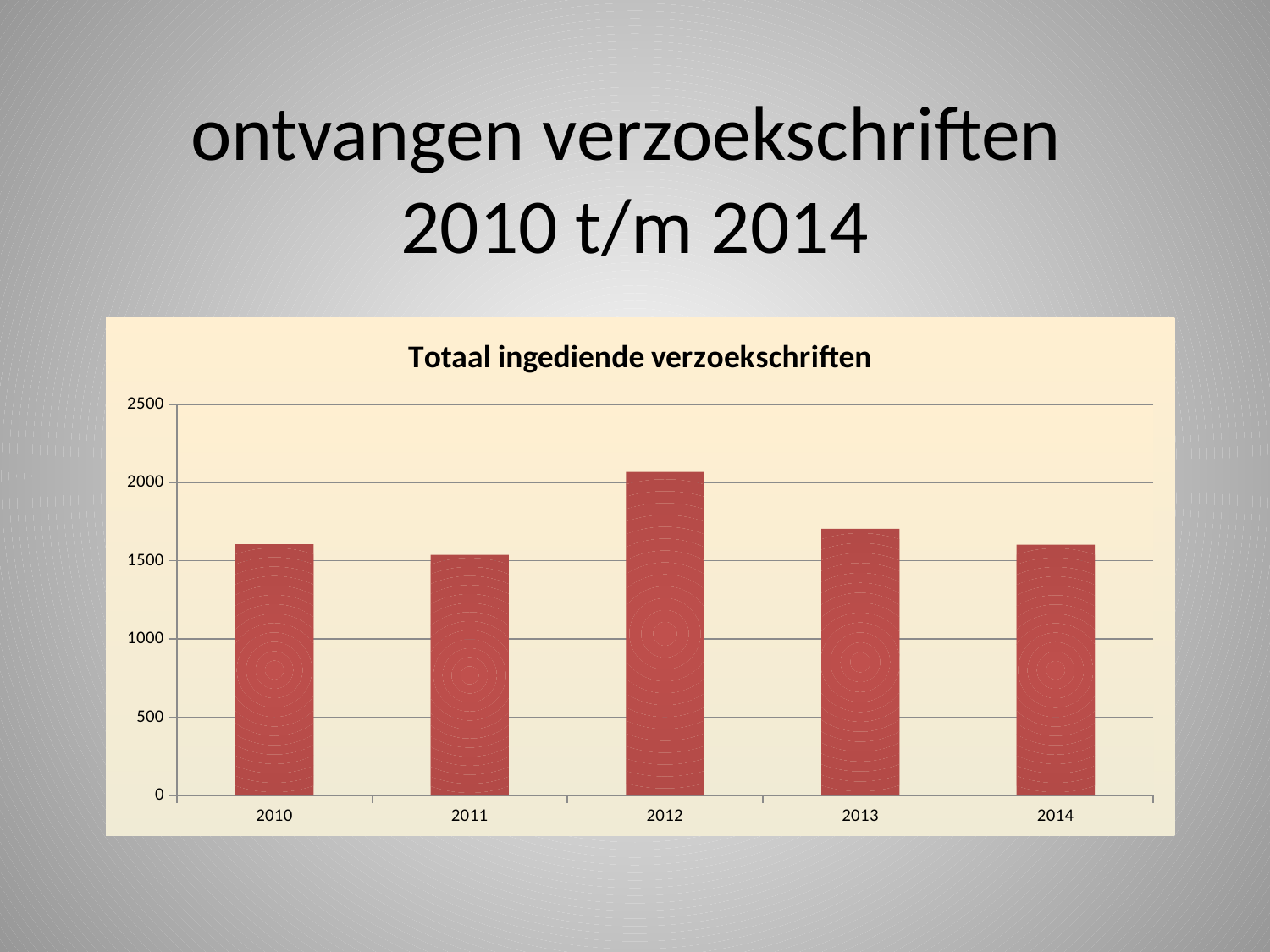
Which year has the lowest value in the chart? 2011 Which is larger, the value for 2012 or the value for 2013? 2012 Do the values rise or fall from 2012 to 2014? fall Is the value for 2012 greater or less than 2000? greater Which year has the highest value in the chart? 2012 Is the value for 2014 greater or less than 2000? less How many years are shown on the x axis of the chart? 5 What kind of chart is shown on the slide? bar chart What is the title of the chart? Totaal ingediende verzoekschriften Is the value for 2013 greater or less than 2000? less Which is larger, the value for 2013 or the value for 2011? 2013